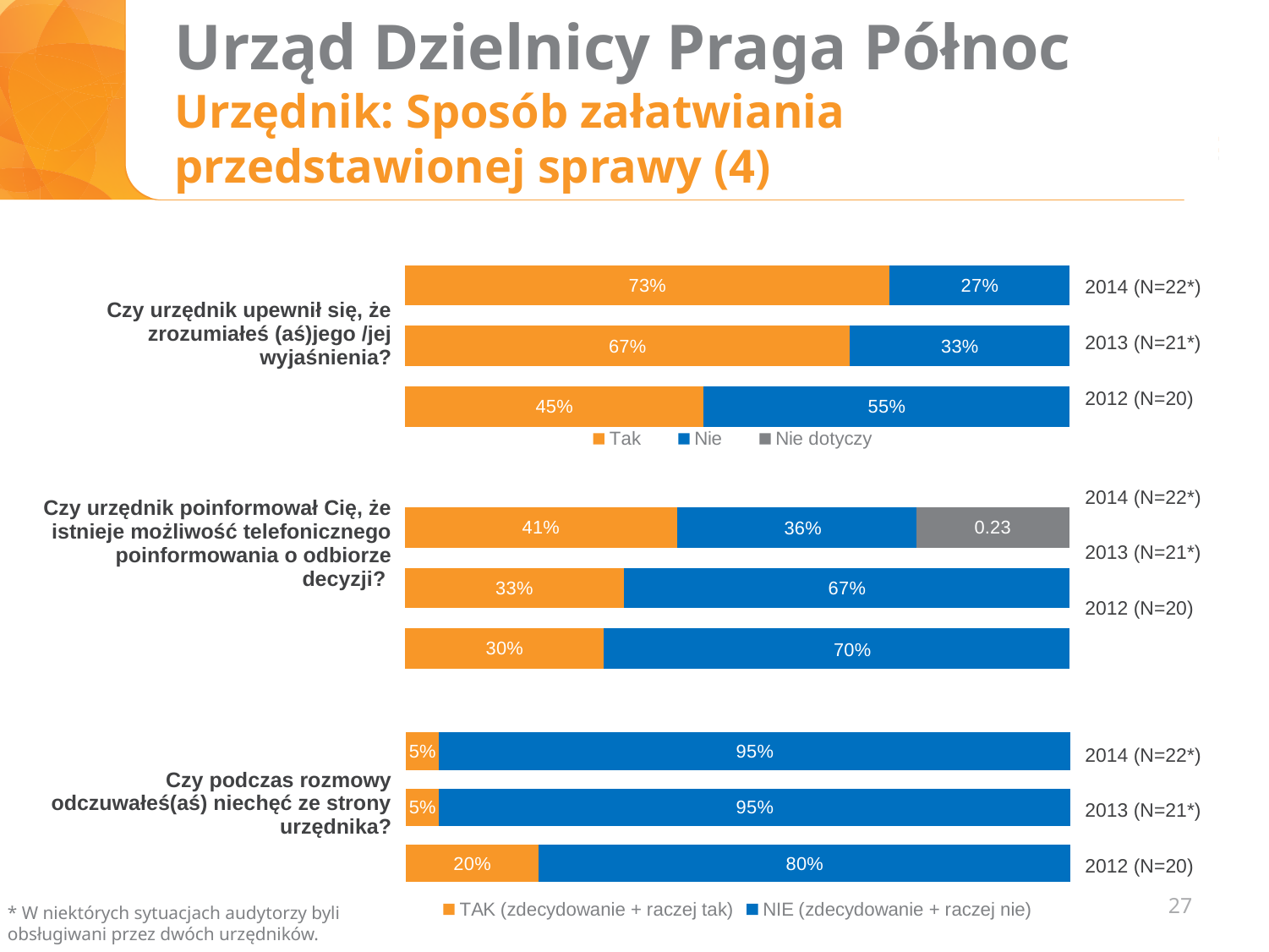
In the top chart ("Czy urzędnik upewnił się..."), which year has the highest Tak value? 2014 (N=22*) In the bottom chart ("Czy podczas rozmowy odczuwałeś(aś) niechęć ze strony urzędnika?"), what is the NIE value for 2012 (N=20)? 80% In the middle chart ("Czy urzędnik poinformował Cię..."), does the Tak value rise or fall from 2012 to 2014? rise In the top chart ("Czy urzędnik upewnił się..."), what is the Nie value for 2012 (N=20)? 55% In the bottom chart ("Czy podczas rozmowy odczuwałeś(aś) niechęć..."), which is larger: the TAK value for 2012 or the TAK value for 2014? 2012 In the middle chart ("Czy urzędnik poinformował Cię..."), which year has the lowest Tak value? 2012 (N=20) What type of chart is used on this slide? stacked bar chart In the middle chart ("Czy urzędnik poinformował Cię, że istnieje możliwość telefonicznego poinformowania o odbiorze decyzji?"), what is the Nie value for 2013 (N=21*)? 67% In the top chart ("Czy urzędnik upewnił się..."), how many entries does the legend list? 3 In the top chart ("Czy urzędnik upewnił się..."), what is the difference between the Tak values for 2014 and 2012? 28% In the top chart ("Czy urzędnik upewnił się, że zrozumiałeś (aś) jego/jej wyjaśnienia?"), what is the Tak value for 2014 (N=22*)? 73% In the middle chart ("Czy urzędnik poinformował Cię..."), what is the Nie dotyczy value for 2014 (N=22*)? 0.23